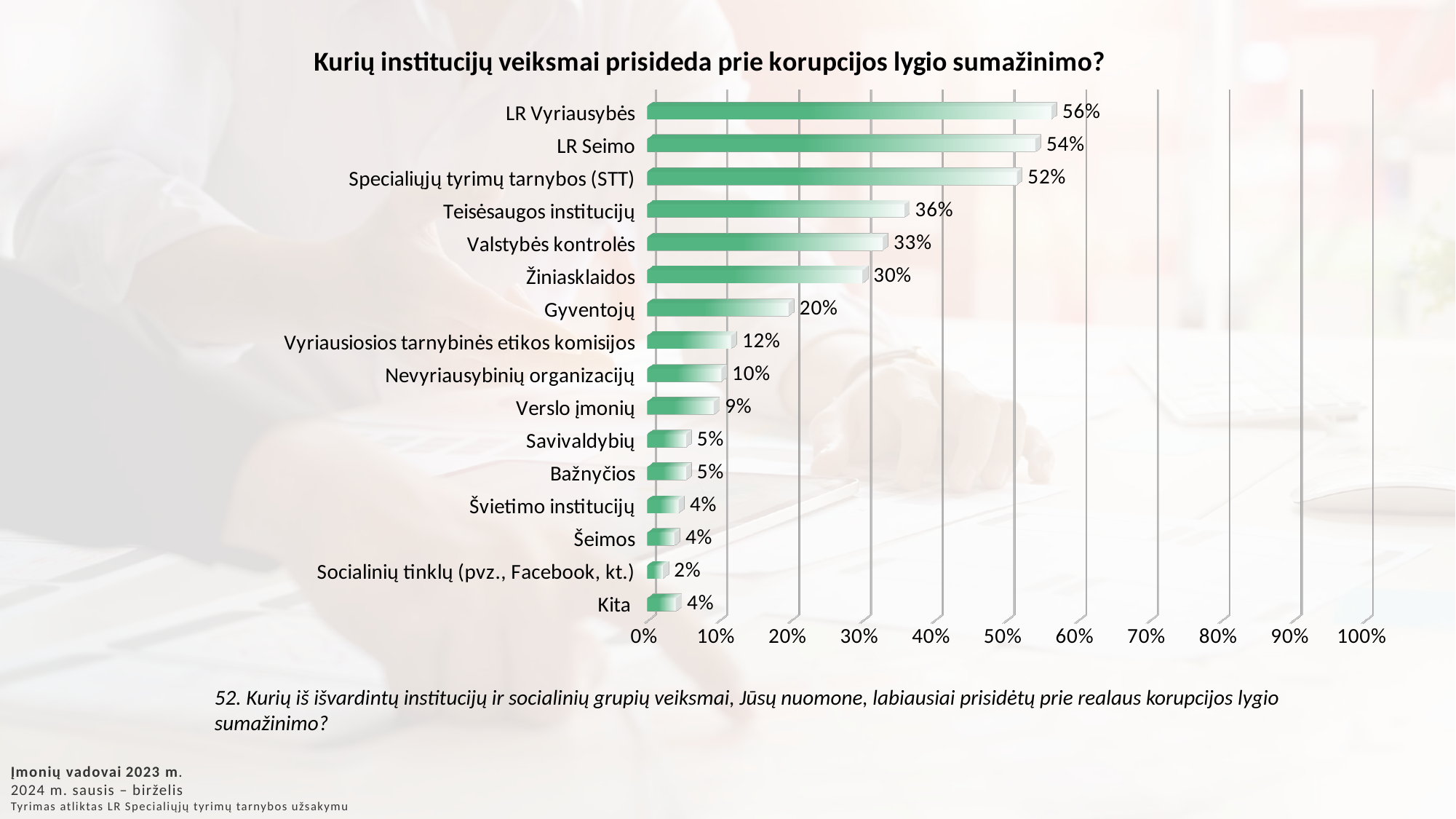
What is the value for Socialinių tinklų (pvz., Facebook, kt.)? 2% What is the value for Žiniasklaidos? 30% Which category has the lowest value? Socialinių tinklų (pvz., Facebook, kt.) Is the value for Teisėsaugos institucijų greater or less than 40%? less What kind of chart is shown on the slide? bar chart What is the value for LR Vyriausybės? 56% What is the title of the chart? Kurių institucijų veiksmai prisideda prie korupcijos lygio sumažinimo? Which category has the highest value? LR Vyriausybės How many categories are shown in the chart? 16 What is the difference between the values for LR Seimo and Teisėsaugos institucijų? 18% Which is larger, the value for Valstybės kontrolės or the value for Gyventojų? Valstybės kontrolės What is the value for Specialiųjų tyrimų tarnybos (STT)? 52%